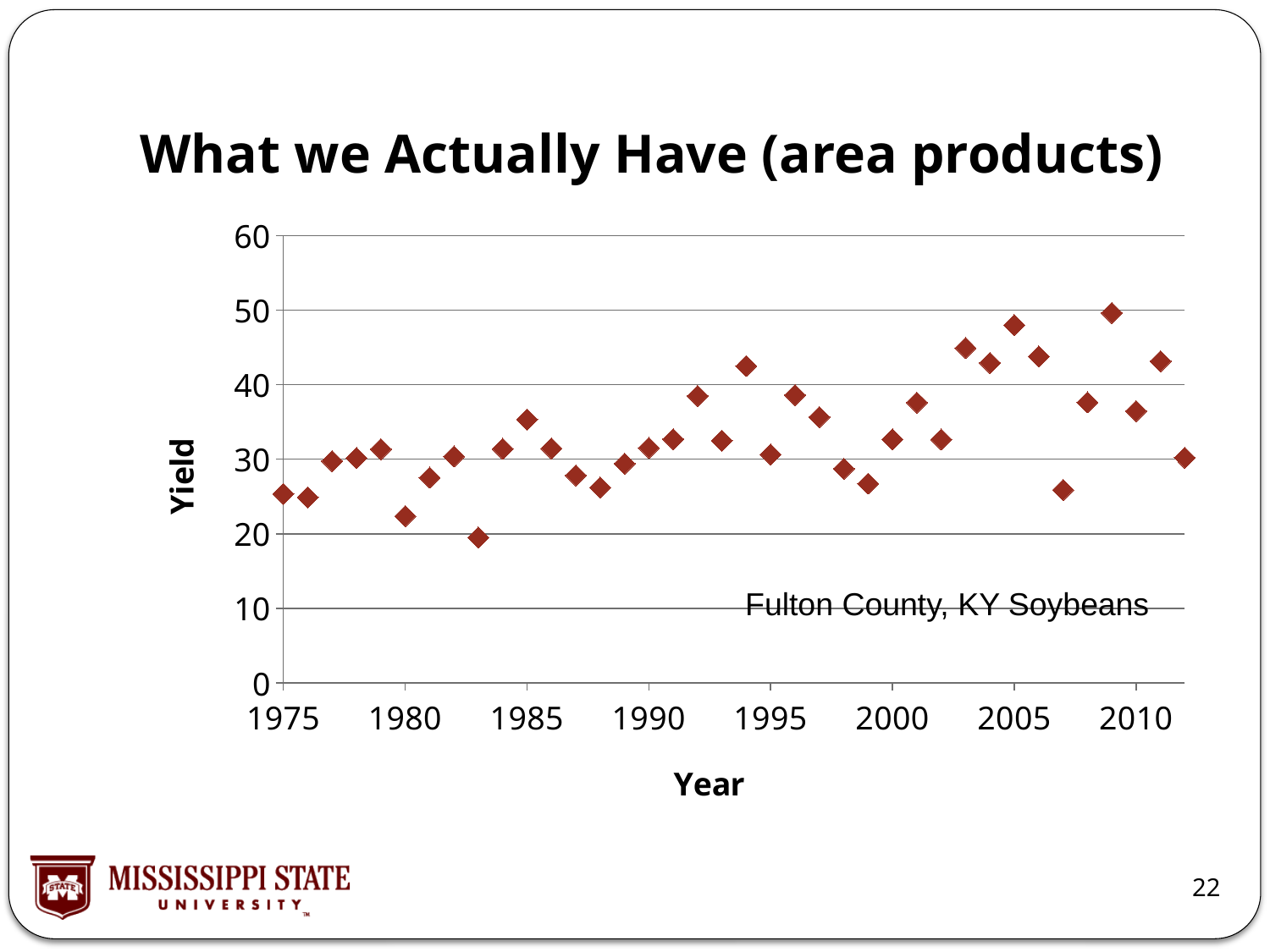
What county and crop does the chart annotation say the data is for? Fulton County, KY Soybeans Which year has the larger yield, 2005 or 2007? 2005 What is the label on the y axis of the chart? Yield Overall, do the yield values rise or fall from 1975 to 2012? Rise Which year has the larger yield, 1983 or 1985? 1985 Is the yield value for 2007 greater or less than 30? less Which year has the lowest soybean yield in the chart? 1983 Is the yield value for 1994 greater or less than 40? greater Which year has the highest soybean yield in the chart? 2009 What kind of chart is shown on the slide? Scatter plot Is the yield value for 2009 greater or less than 40? greater